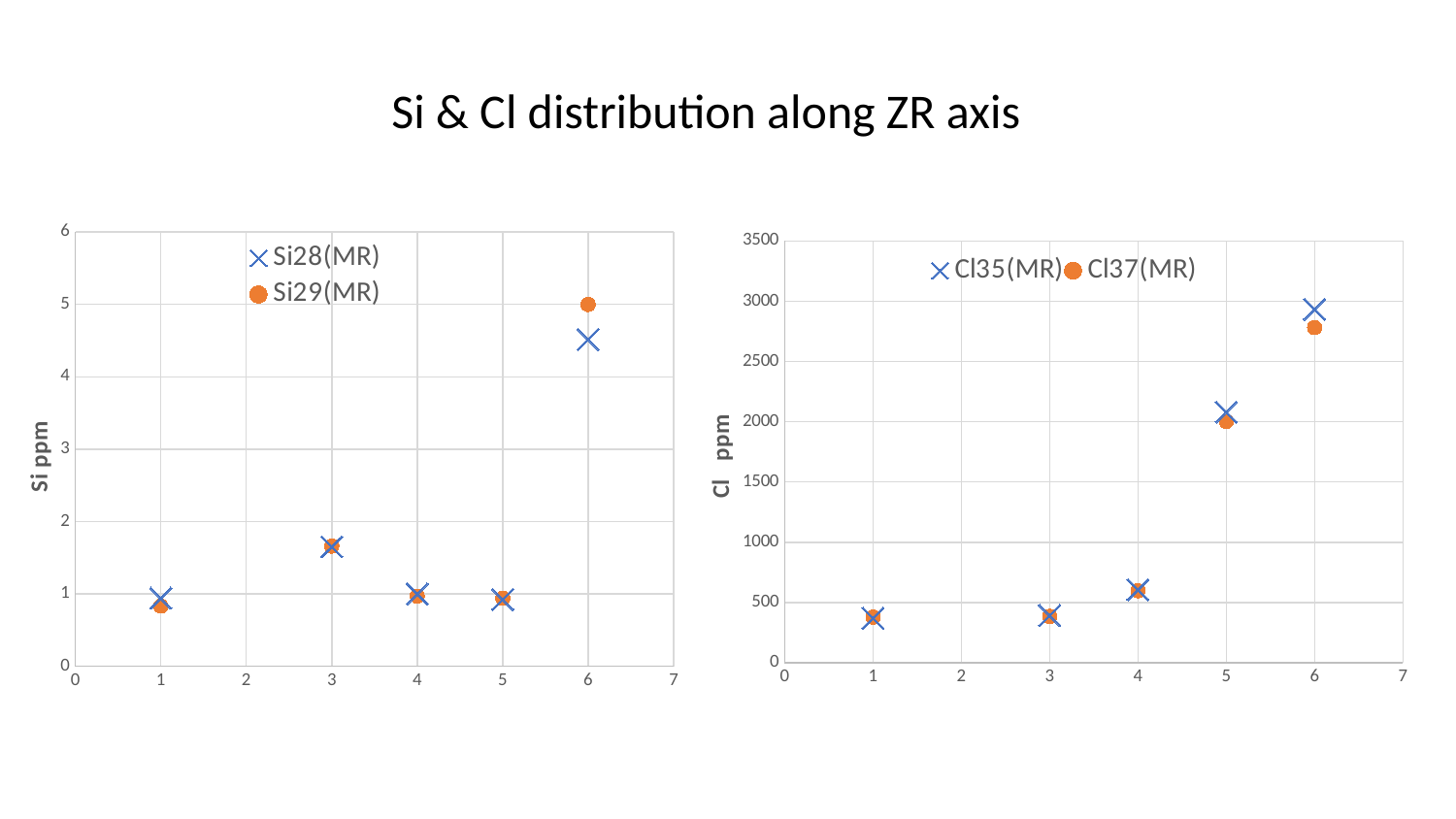
How many series does the legend of the left chart (Si ppm) list? 2 In the left chart (Si ppm), which series has the higher value at x = 6? Si29(MR) In the right chart (Cl ppm), how many data points are plotted for the Cl35(MR) series? 5 In the left chart (Si ppm), is the Si28(MR) value at x = 6 greater or less than 5? less In the left chart (Si ppm), is the Si28(MR) value at x = 3 greater or less than 1? greater How many series does the legend of the right chart (Cl ppm) list? 2 What kind of chart is the left chart (Si ppm)? scatter chart In the left chart (Si ppm), is the Si29(MR) value at x = 6 greater or less than 4? greater In the right chart (Cl ppm), which series has the higher value at x = 6? Cl35(MR) In the left chart (Si ppm), at which x value does the Si29(MR) series reach its highest point? 6